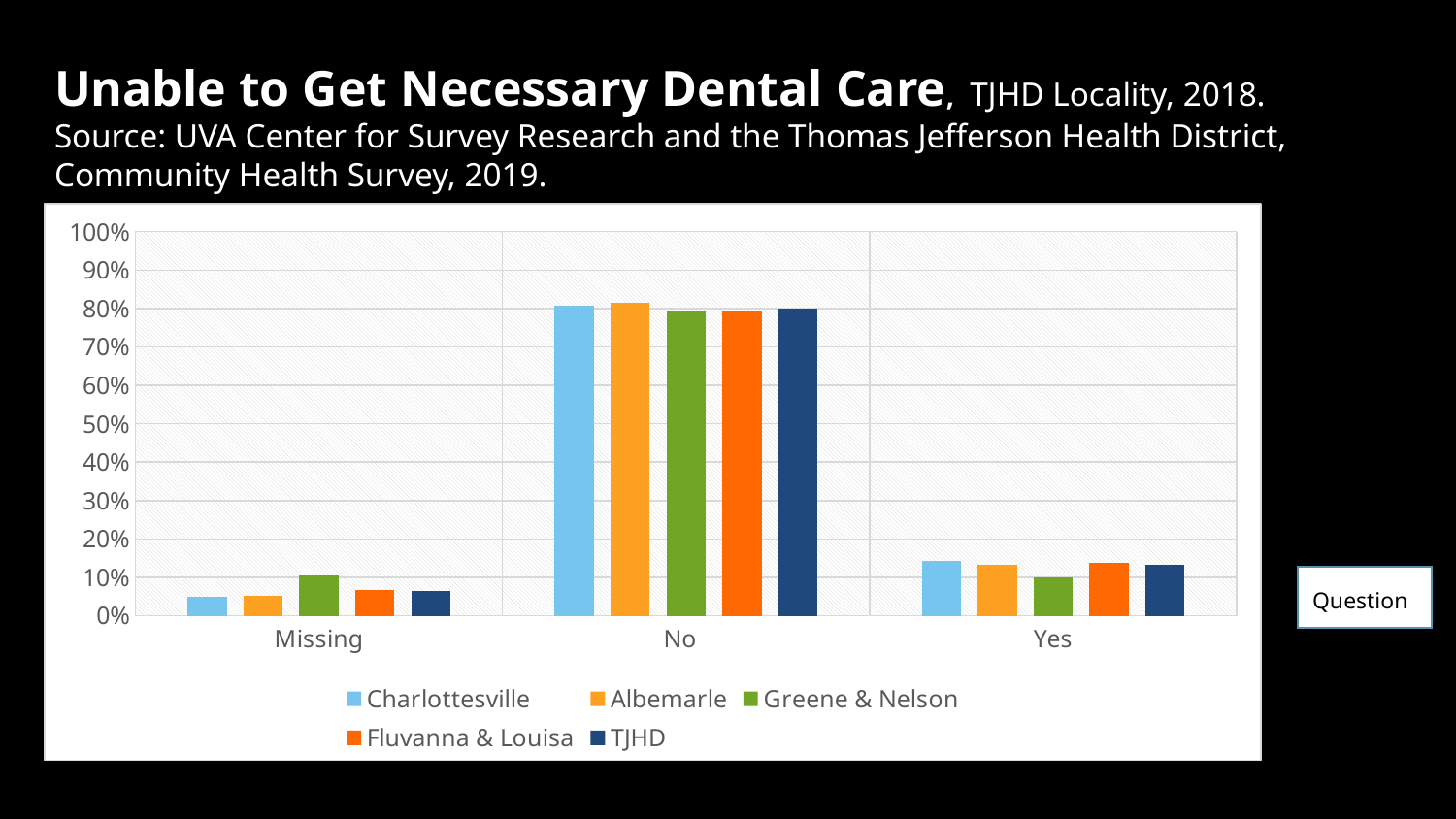
How many series does the legend list? 5 Is the value for TJHD in the Yes category greater or less than 10%? greater What kind of chart is shown on the slide? bar chart Which legend entry is shown in green? Greene & Nelson How many categories are shown on the x axis? 3 Is the value for Charlottesville in the No category greater or less than 70%? greater Is the value for Greene & Nelson in the Missing category greater or less than 20%? less Which is larger for TJHD: the Missing value or the Yes value? Yes Within the Yes category, which locality has the lowest value? Greene & Nelson Within the Missing category, which locality has the highest value? Greene & Nelson Which category has the highest values across all localities? No